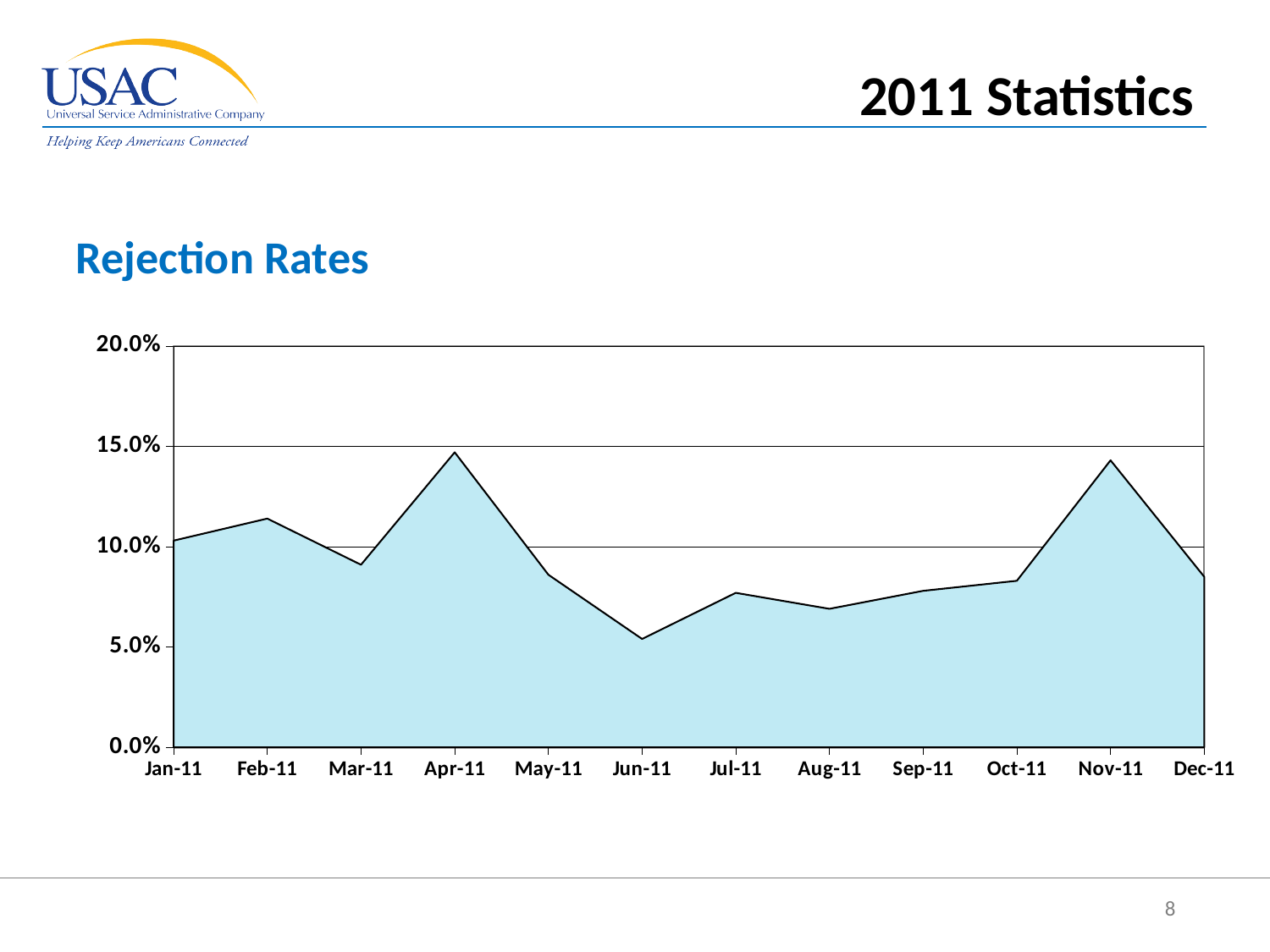
Which month has the higher rejection rate, Feb-11 or Mar-11? Feb-11 Which month has the lowest rejection rate? Jun-11 Does the rejection rate rise or fall from Aug-11 to Nov-11? Rise Does the rejection rate rise or fall from Apr-11 to Jun-11? Fall What kind of chart is shown on the slide? Area chart Is the rejection rate for Aug-11 greater or less than 10.0%? less What is the title of the chart? Rejection Rates Which month has the higher rejection rate, Jun-11 or Jul-11? Jul-11 Is the rejection rate for Feb-11 greater or less than 10.0%? greater How many months are plotted along the x axis? 12 Is the rejection rate for Mar-11 greater or less than 10.0%? less